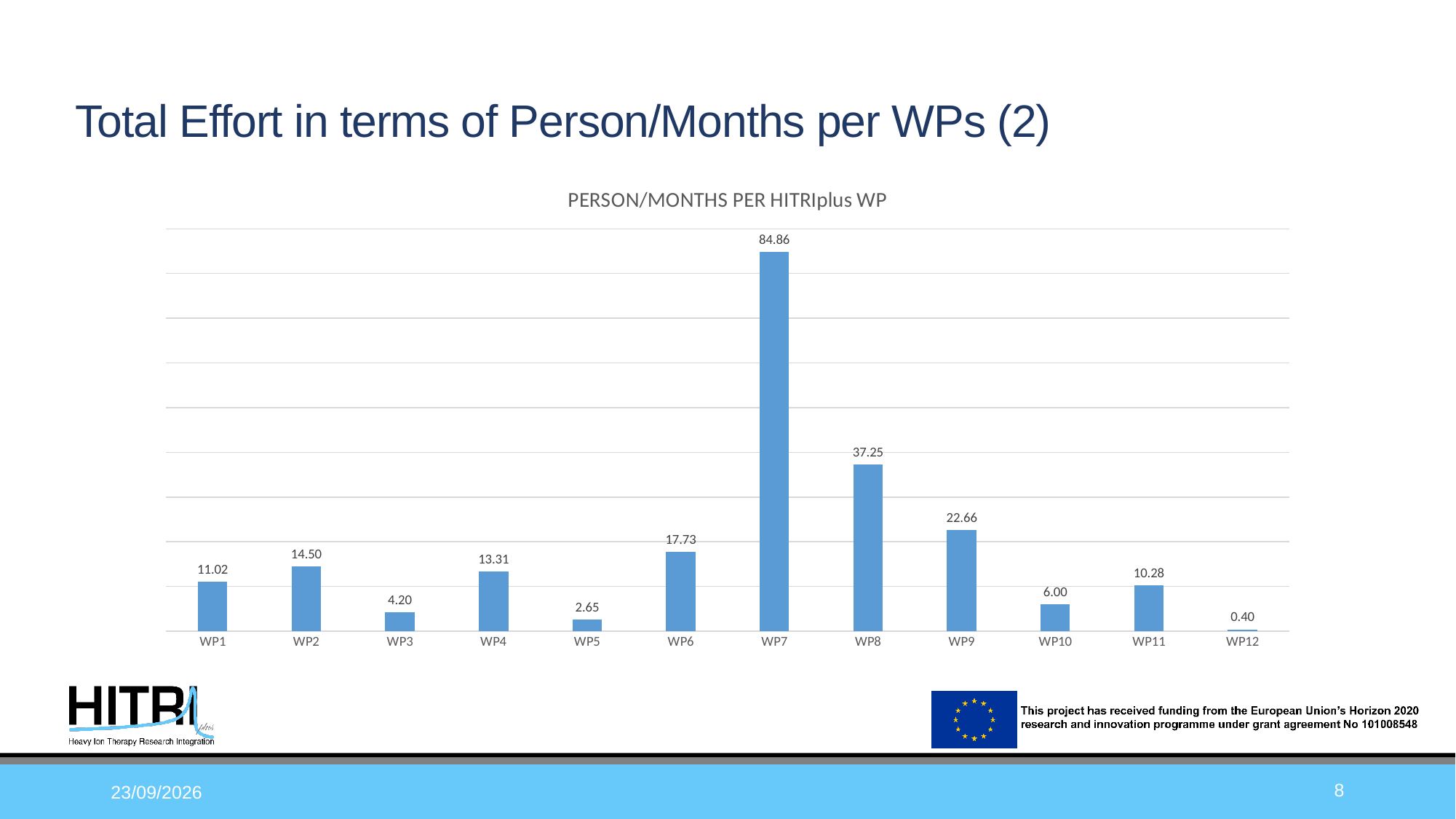
What is the difference between the values for WP7 and WP8? 47.61 Which WP has the lowest value? WP12 Which is larger, the value for WP4 or the value for WP11? WP4 What is the title of the chart? PERSON/MONTHS PER HITRIplus WP How many WPs are shown on the chart? 12 Which is larger, the value for WP6 or the value for WP9? WP9 What is the value for WP10? 6.00 What kind of chart is shown on the slide? bar chart What is the difference between the values for WP2 and WP1? 3.48 What is the value for WP7? 84.86 What is the value for WP3? 4.20 Which WP has the highest value? WP7